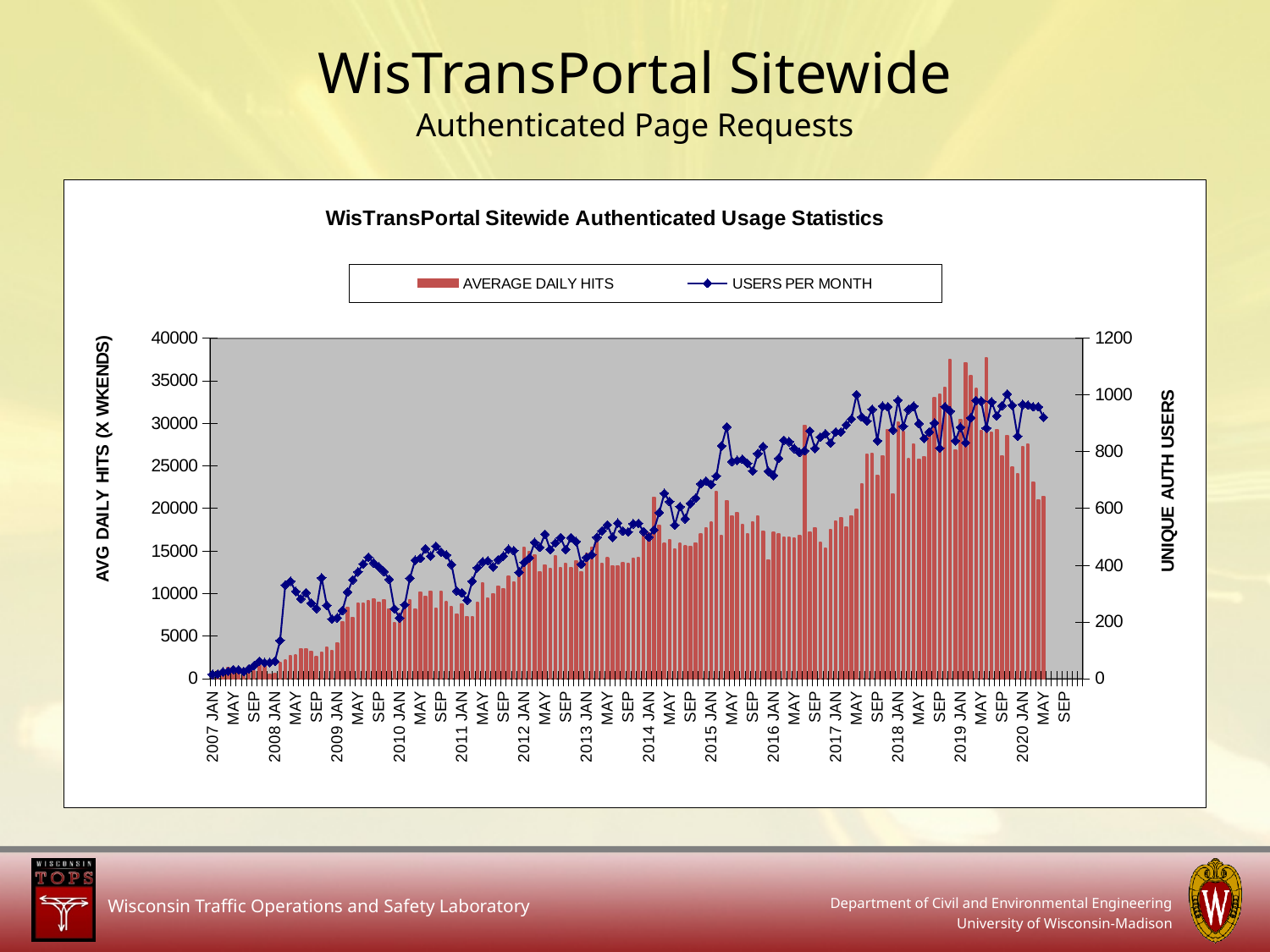
Overall, do the USERS PER MONTH values rise or fall from 2007 to 2020? Rise What kind of chart is shown on the slide? Combination bar and line chart Is the AVERAGE DAILY HITS value for 2007 JAN greater or less than 5000? less Is the tallest AVERAGE DAILY HITS bar greater or less than 35000? greater What is the title of the chart? WisTransPortal Sitewide Authenticated Usage Statistics Which series is plotted as bars? AVERAGE DAILY HITS Is the USERS PER MONTH value for 2020 JAN greater or less than 800? greater Which has the higher AVERAGE DAILY HITS value, 2007 JAN or 2018 JAN? 2018 JAN What is the label of the right-hand vertical axis? UNIQUE AUTH USERS How many series does the chart legend list? 2